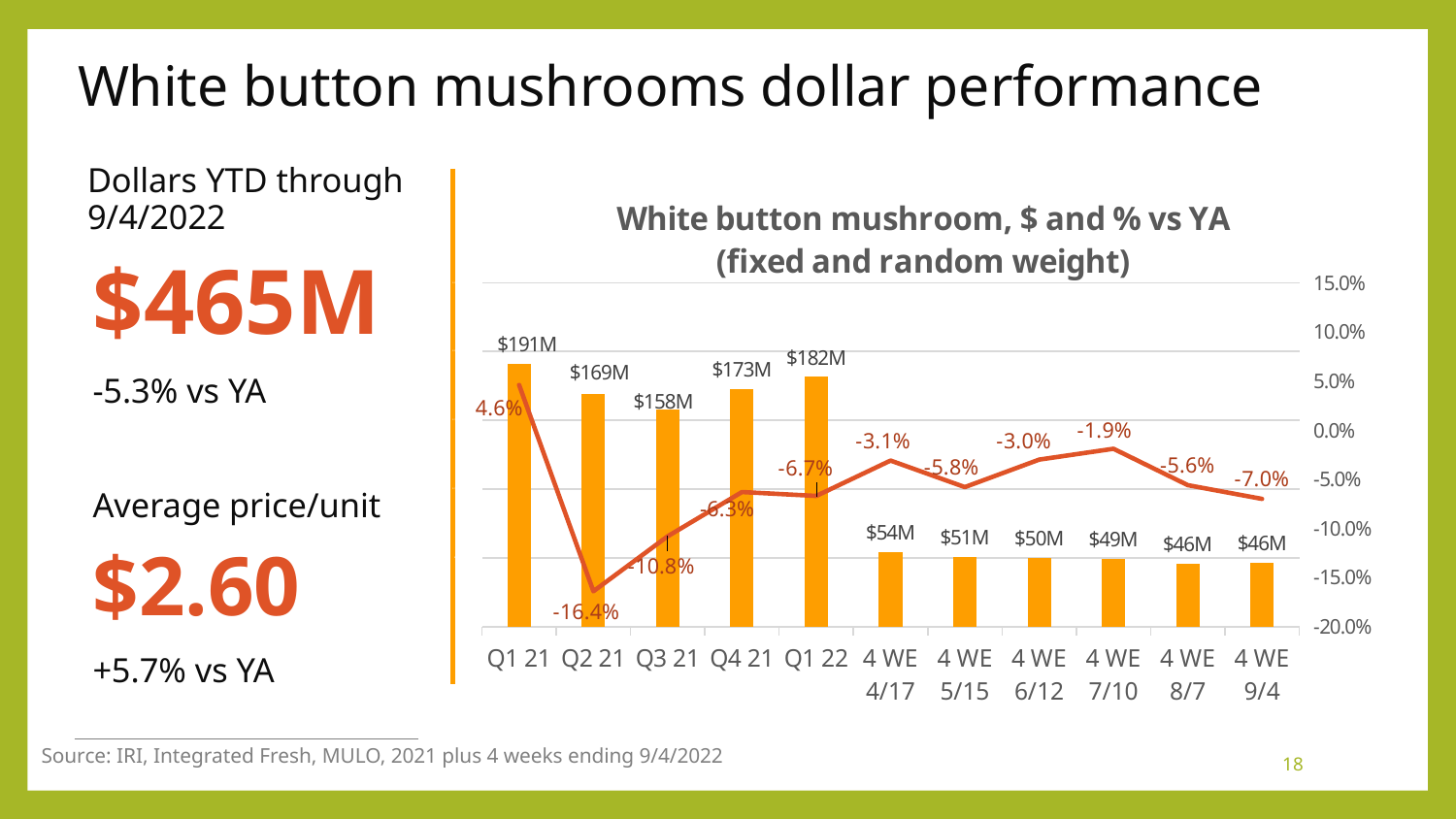
What is the % vs YA value for Q2 21? -16.4% What kind of chart is this? Combination bar and line chart Which is larger, the dollar value for Q2 21 or Q3 21? Q2 21 Which period has the highest dollar value? Q1 21 What is the % vs YA value for the 4 WE 7/10 period? -1.9% What is the dollar value for Q1 21? $191M What is the dollar value for the 4 WE 9/4 period? $46M How many periods are shown on the x axis? 11 What is the title of the chart? White button mushroom, $ and % vs YA (fixed and random weight) Do the dollar values rise or fall across the six 4 WE periods from 4/17 to 9/4? Fall Which period has the lowest % vs YA value? Q2 21 What is the difference in dollar value between Q1 22 and Q4 21? $9M